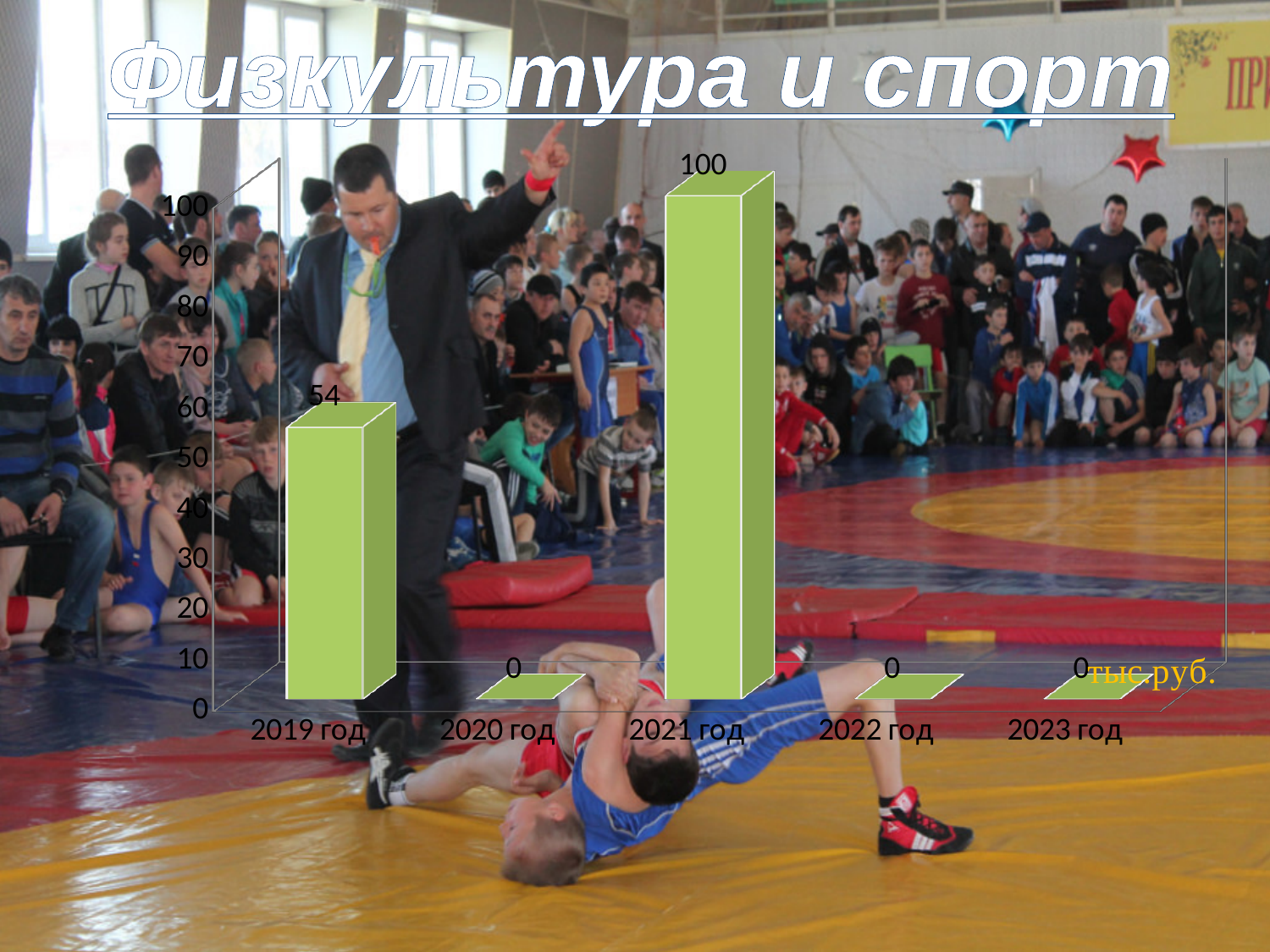
Is the value for 2019 год greater or less than 60? less What unit label is shown next to the chart? тыс.руб. What is the difference between the values for 2021 год and 2019 год? 46 What is the value for 2023 год? 0 What is the value for 2019 год? 54 How many years are shown on the x axis? 5 What kind of chart is shown on the slide? bar chart What is the value for 2021 год? 100 How many years have a value of 0? 3 What is the value for 2020 год? 0 Which year has the highest value? 2021 год Which is larger, the value for 2019 год or the value for 2021 год? 2021 год